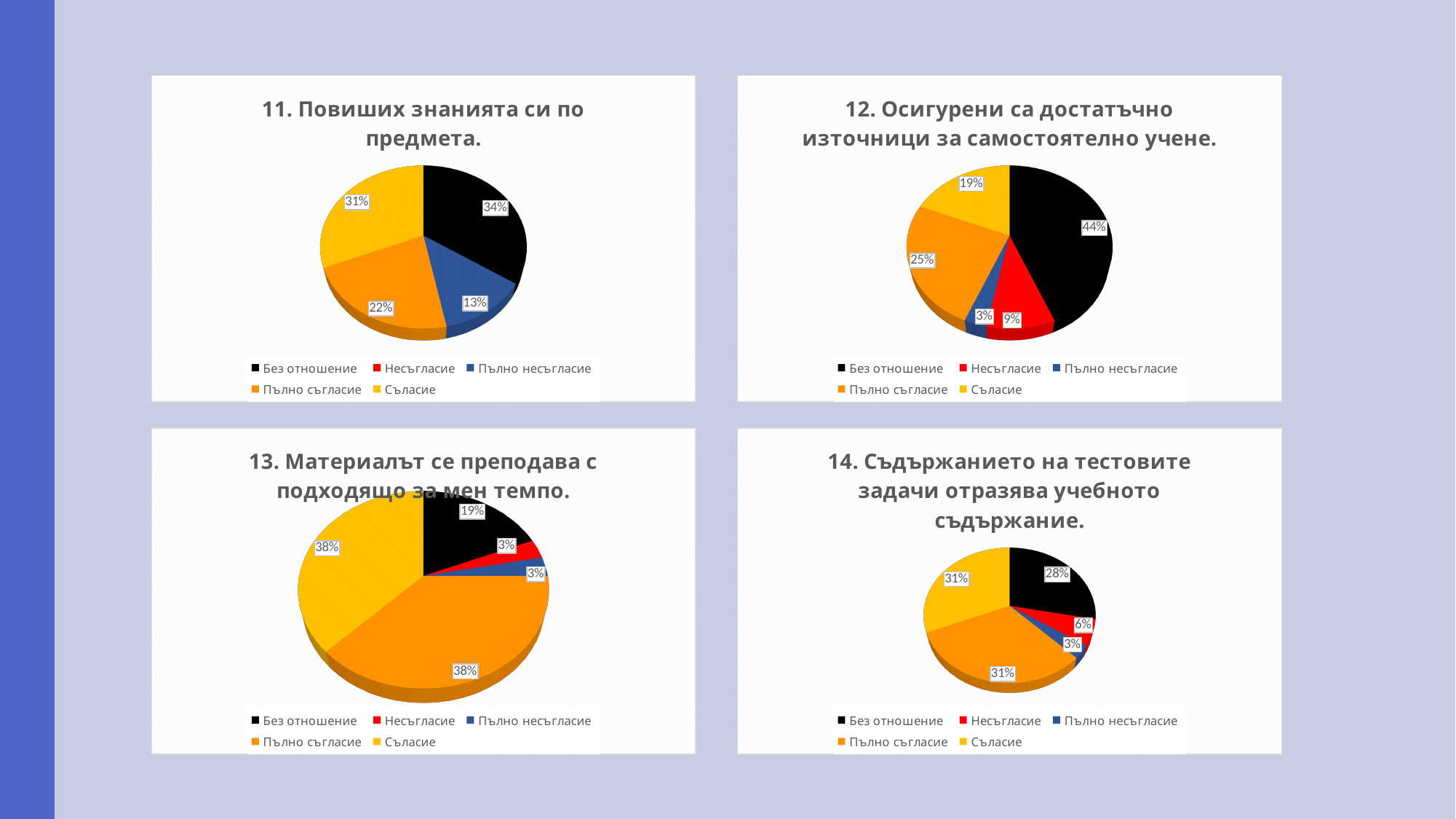
In the chart titled "14. Съдържанието на тестовите задачи отразява учебното съдържание.", what is the difference between "Съгласие" and "Без отношение"? 3% In the chart titled "13. Материалът се преподава с подходящо за мен темпо.", which is larger, "Пълно съгласие" or "Без отношение"? Пълно съгласие How many entries does the legend of the top-right chart list? 5 In the chart titled "11. Повиших знанията си по предмета.", which category has the largest slice? Без отношение In the chart titled "11. Повиших знанията си по предмета.", what is the value for "Пълно несъгласие"? 13% What kind of chart is used in the bottom-left chart on the slide? Pie chart In the chart titled "14. Съдържанието на тестовите задачи отразява учебното съдържание.", what is the value for "Несъгласие"? 6% In the chart titled "12. Осигурени са достатъчно източници за самостоятелно учене.", what is the difference between "Без отношение" and "Пълно съгласие"? 19% In the chart titled "12. Осигурени са достатъчно източници за самостоятелно учене.", what is the value for "Несъгласие"? 9% In the chart titled "11. Повиших знанията си по предмета.", what share does the "Без отношение" slice have? 34% In the chart titled "12. Осигурени са достатъчно източници за самостоятелно учене.", which category has the smallest slice? Пълно несъгласие In the chart titled "13. Материалът се преподава с подходящо за мен темпо.", what is the value for "Без отношение"? 19%